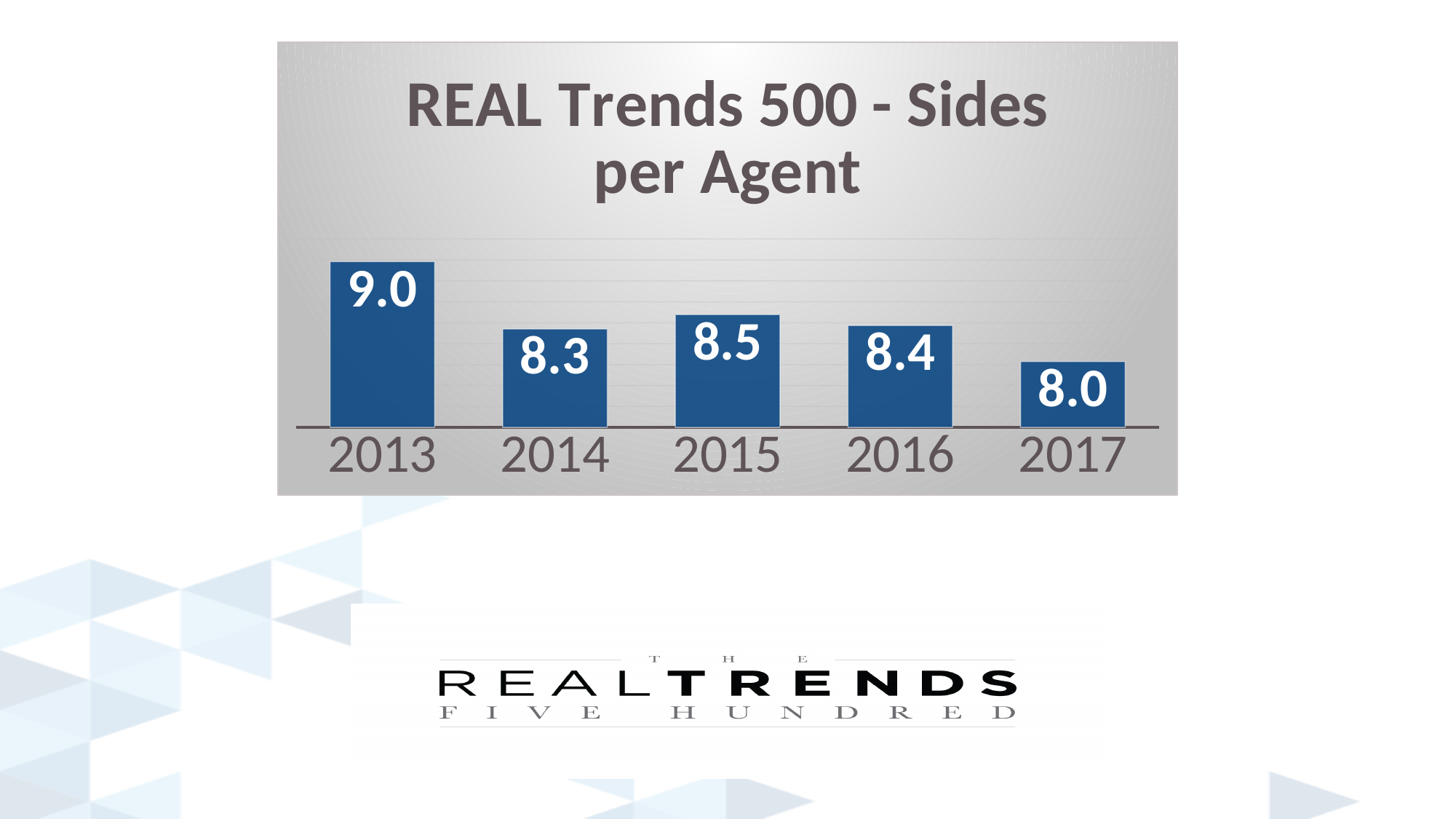
Which is larger, the value for 2014 or the value for 2016? 2016 What kind of chart is shown? bar chart What is the difference between the values for 2013 and 2017? 1.0 What is the title of the chart? REAL Trends 500 - Sides per Agent Which year has the highest sides per agent? 2013 What is the value for 2015? 8.5 What is the value for 2013? 9.0 Which year has the lowest sides per agent? 2017 What is the value for 2017? 8.0 Do the values generally rise or fall from 2013 to 2017? fall How many years are shown on the chart? 5 What is the difference between the values for 2015 and 2014? 0.2